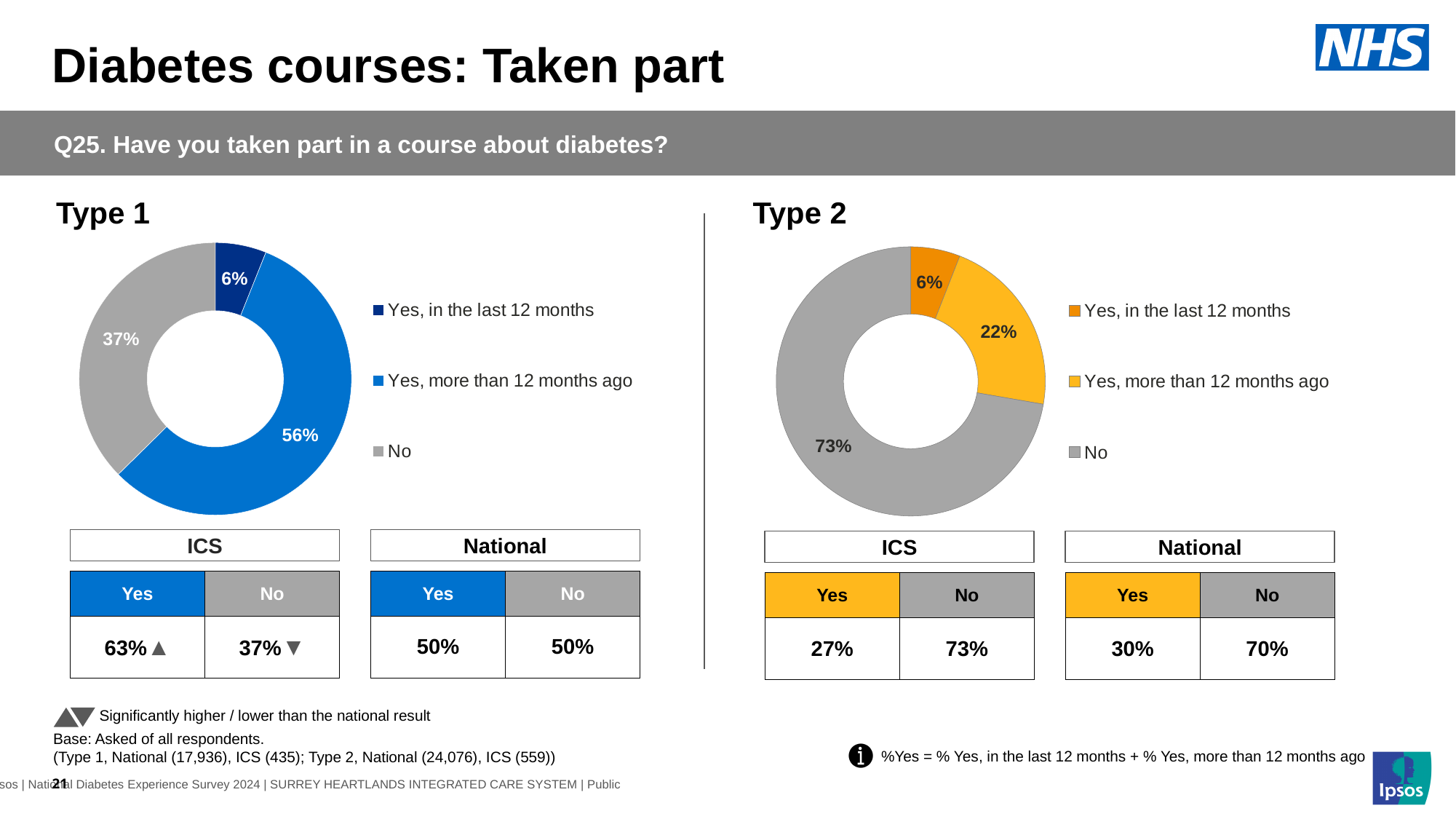
In the Type 2 chart, what percentage answered 'Yes, more than 12 months ago'? 22% In the Type 1 chart, what percentage of respondents answered 'No'? 37% In the Type 1 chart, which category has the smallest share? Yes, in the last 12 months In the Type 1 chart, what is the difference between the 'Yes, more than 12 months ago' share and the 'No' share? 19% What type of chart is used for Type 1? Doughnut chart How many entries does the legend of the Type 1 chart list? 3 In the Type 1 chart, what percentage answered 'Yes, in the last 12 months'? 6% In the Type 2 chart, which category has the largest share? No In the Type 1 chart, what colour is the 'No' segment? Grey How many categories does the Type 2 chart show? 3 In the Type 2 chart, what is the combined share of the two 'Yes' categories? 28% Which is larger in the Type 2 chart: 'Yes, more than 12 months ago' or 'No'? No